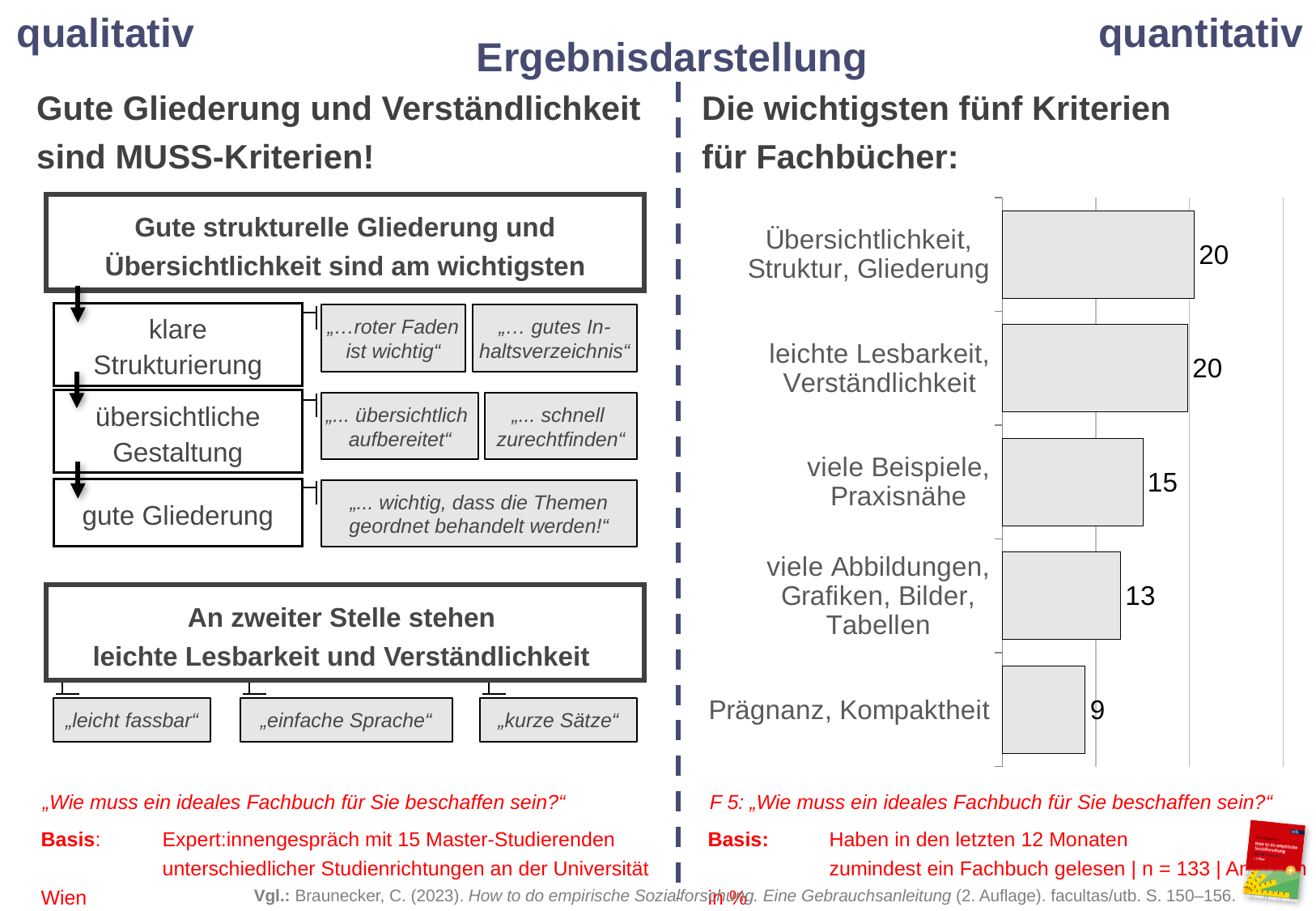
How many categories are shown in the chart? 5 What value is shown for "leichte Lesbarkeit, Verständlichkeit"? 20 What kind of chart is shown on the slide? bar chart What value is shown for "viele Abbildungen, Grafiken, Bilder, Tabellen"? 13 Which category has the lowest value in the chart? Prägnanz, Kompaktheit What is the difference between the values for "Übersichtlichkeit, Struktur, Gliederung" and "viele Abbildungen, Grafiken, Bilder, Tabellen"? 7 What value is shown for "Prägnanz, Kompaktheit"? 9 Which is larger: the value for "viele Beispiele, Praxisnähe" or the value for "viele Abbildungen, Grafiken, Bilder, Tabellen"? viele Beispiele, Praxisnähe Do the values rise or fall going from the top bar to the bottom bar? fall What is the difference between the values for "viele Beispiele, Praxisnähe" and "Prägnanz, Kompaktheit"? 6 What value is shown for "viele Beispiele, Praxisnähe"? 15 What is the heading above the chart on the right side of the slide? Die wichtigsten fünf Kriterien für Fachbücher: